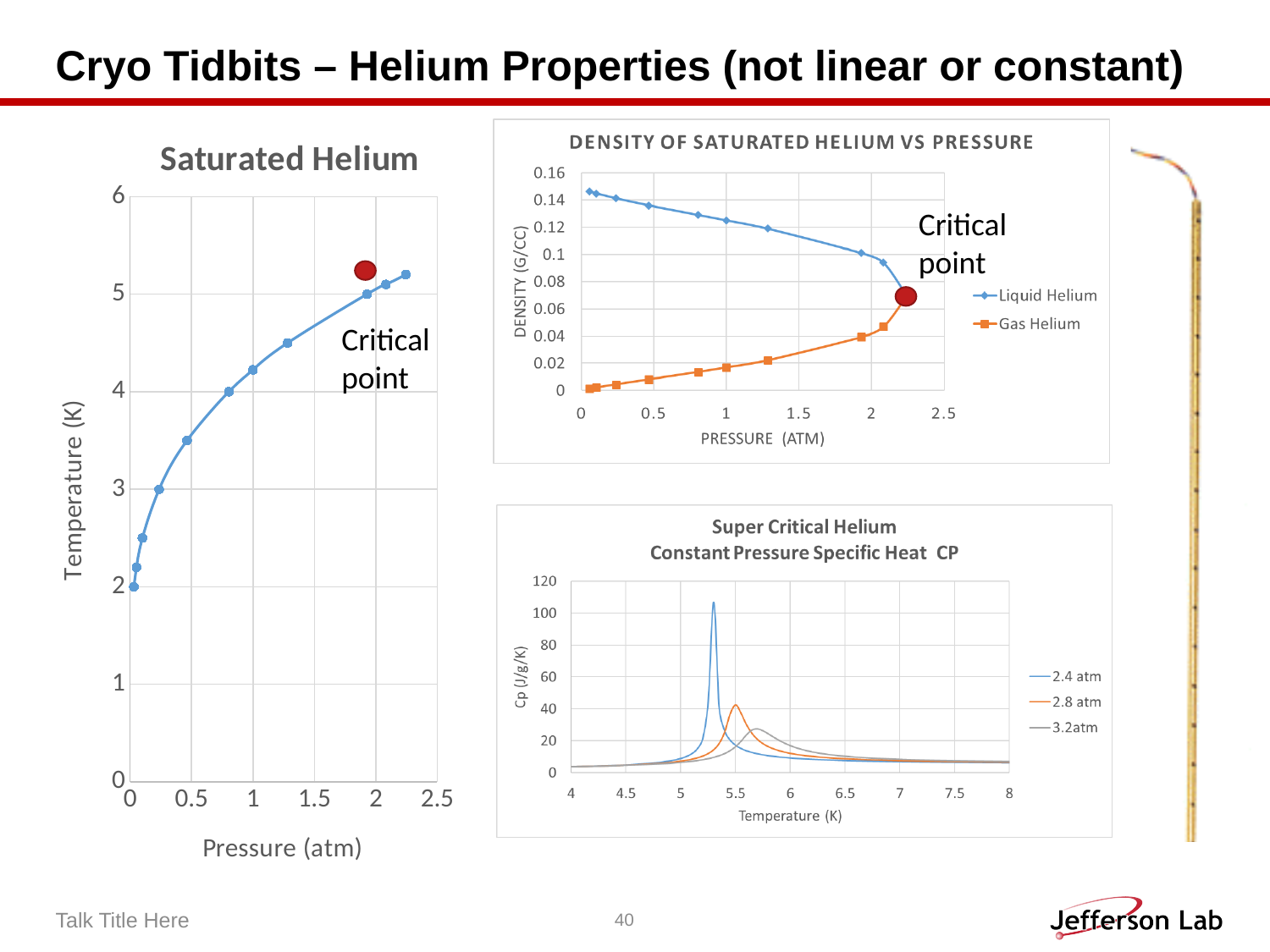
In the "Super Critical Helium Constant Pressure Specific Heat CP" chart, is the peak Cp of the 2.4 atm series greater or less than 100 J/g/K? greater In the "DENSITY OF SATURATED HELIUM VS PRESSURE" chart, does the Liquid Helium density rise or fall as pressure increases? fall What type of chart is the "Saturated Helium" chart on the left? line chart In the "Saturated Helium" chart, what is the label of the y axis? Temperature (K) In the "Saturated Helium" chart, does temperature rise or fall as pressure increases? rise How many series does the legend of the "Super Critical Helium Constant Pressure Specific Heat CP" chart list? 3 In the "DENSITY OF SATURATED HELIUM VS PRESSURE" chart, which series has the higher density at 1 atm, Liquid Helium or Gas Helium? Liquid Helium In the "Saturated Helium" chart, is the temperature at 1 atm greater or less than 4 K? greater In the "Super Critical Helium Constant Pressure Specific Heat CP" chart, which series reaches the highest peak Cp? 2.4 atm In the "DENSITY OF SATURATED HELIUM VS PRESSURE" chart, does the Gas Helium density rise or fall as pressure increases? rise How many series does the legend of the "DENSITY OF SATURATED HELIUM VS PRESSURE" chart list? 2